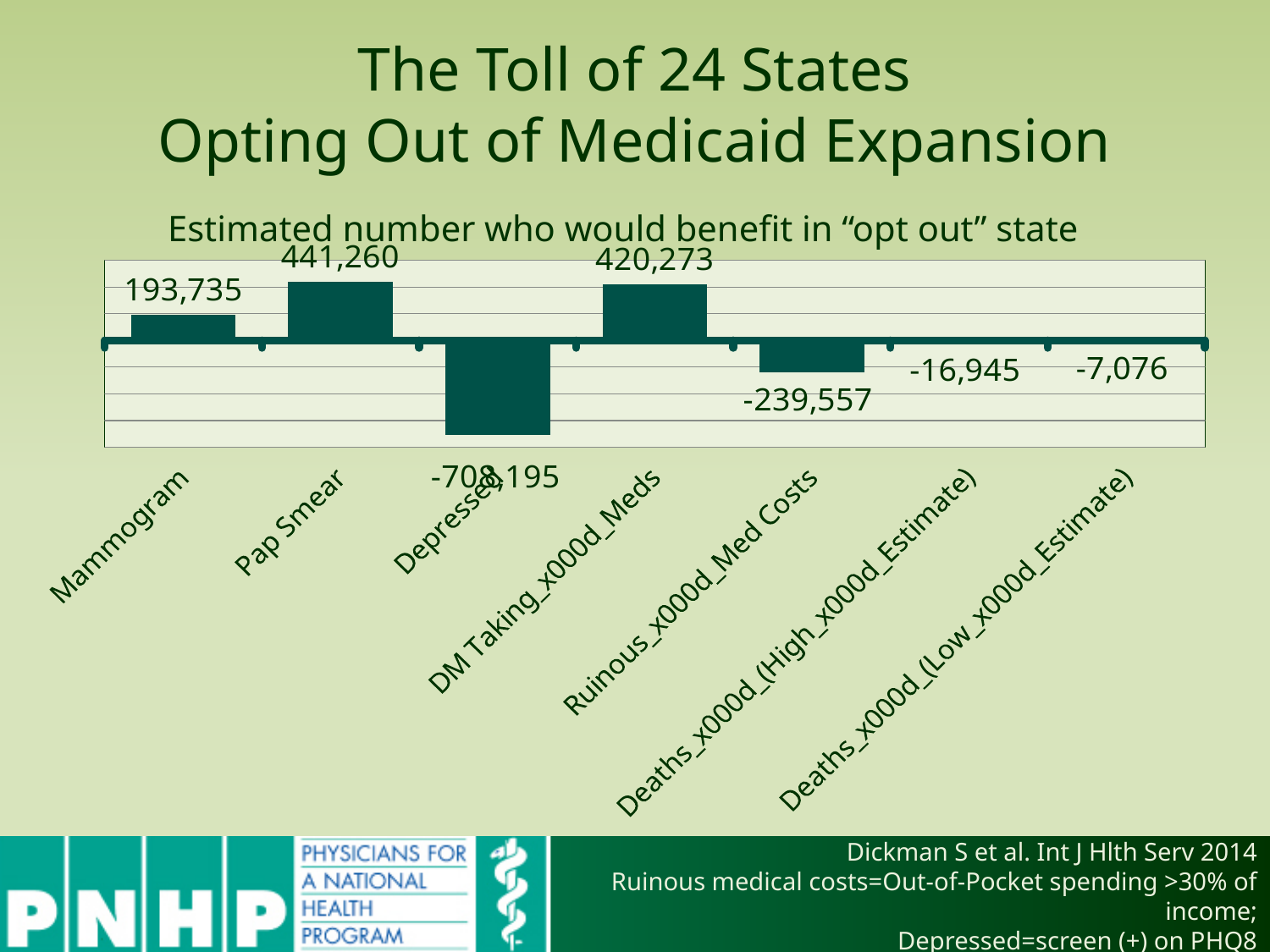
What is the value for Deaths (Low Estimate)? -7,076 How many categories are shown in the chart? 7 Which category has the highest value? Pap Smear What is the value for Pap Smear? 441,260 Which is larger, the value for Mammogram or the value for DM Taking Meds? DM Taking Meds What is the difference between the values for Pap Smear and DM Taking Meds? 20,987 What is the value for Mammogram? 193,735 Which category has the lowest value? Depressed What kind of chart is shown on the slide? Bar chart What is the value for Deaths (High Estimate)? -16,945 What is the value for DM Taking Meds? 420,273 What is the value for Ruinous Med Costs? -239,557